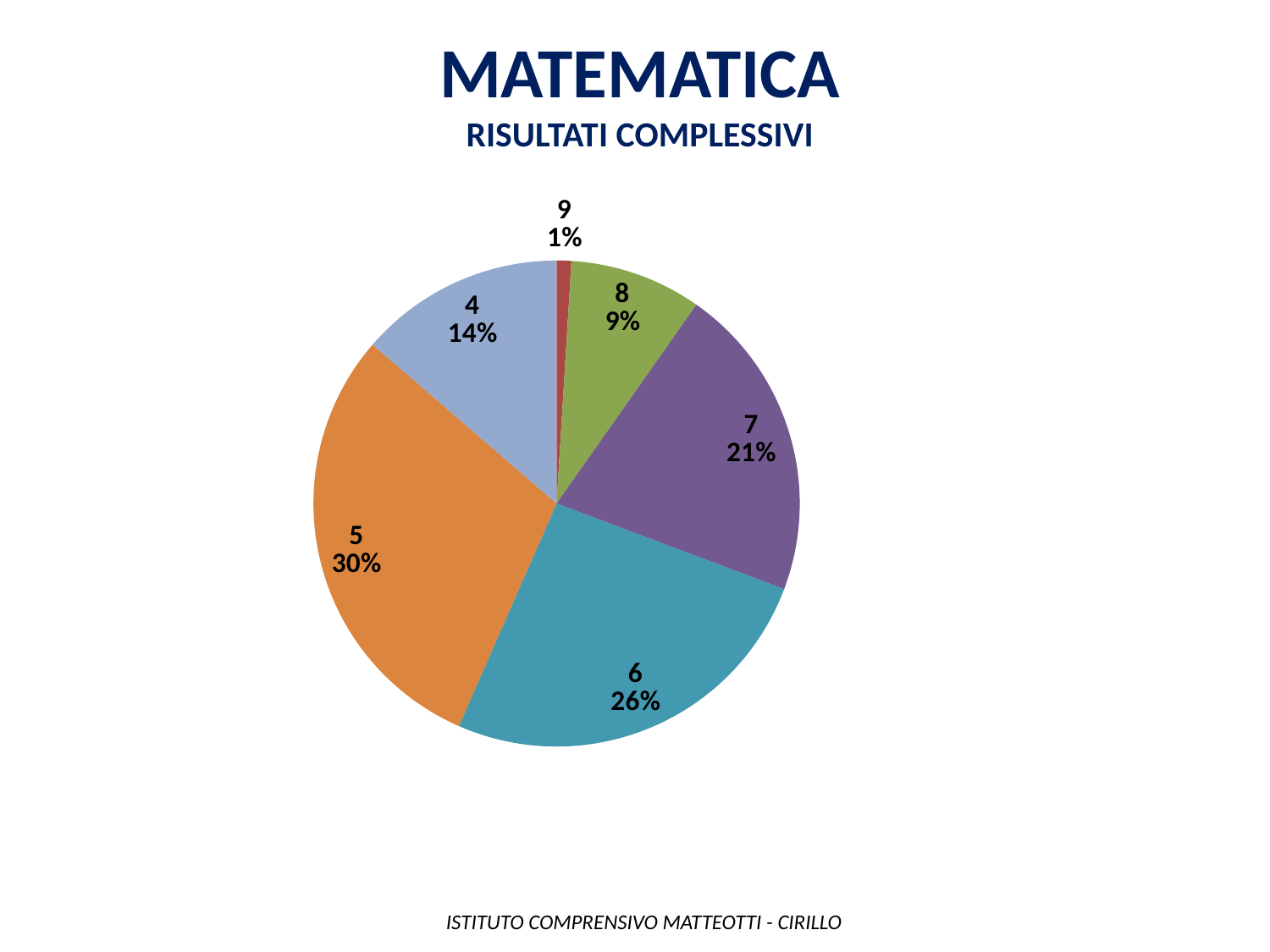
How many slices does the pie chart have? 6 Which grade has the smallest slice of the pie? 9 What kind of chart is shown on the slide? pie chart What is the title shown above the chart? MATEMATICA RISULTATI COMPLESSIVI Which slice is larger, grade 4 or grade 8? 4 What share of the pie does grade 9 have? 1% What share of the pie does grade 6 have? 26% What share of the pie does grade 5 have? 30% What is the combined share of grades 8 and 9? 10% What is the difference in percentage points between the slices for grade 5 and grade 6? 4 Which grade has the largest slice of the pie? 5